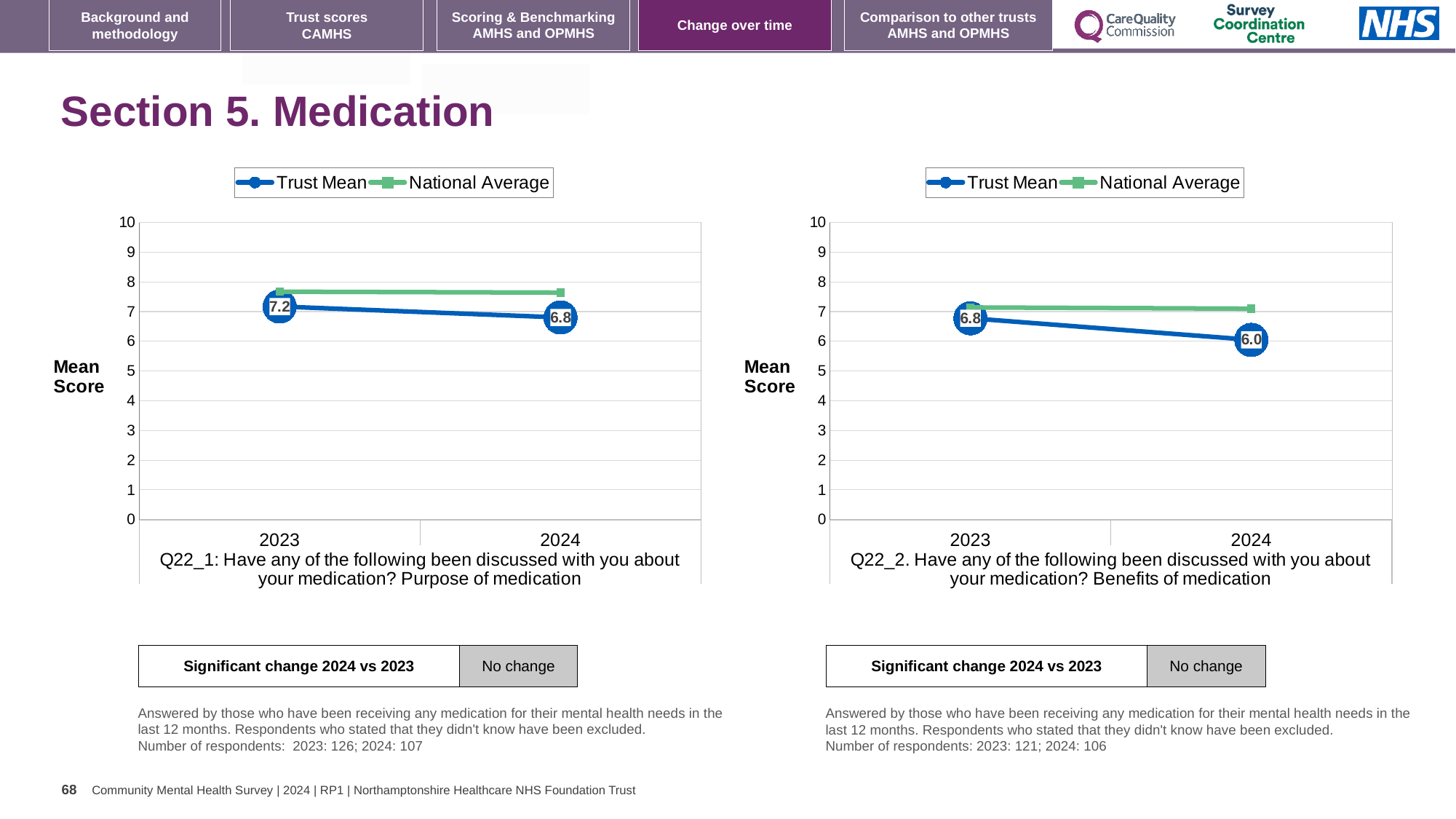
In the left chart (Q22_1: Purpose of medication), is the National Average for 2023 greater or less than 7? greater In the right chart (Q22_2: Benefits of medication), what is the Trust Mean score for 2024? 6.0 In the right chart (Q22_2: Benefits of medication), does the Trust Mean rise or fall from 2023 to 2024? fall In the right chart (Q22_2: Benefits of medication), what is the difference between the Trust Mean in 2023 and 2024? 0.8 How many series does the legend of the left chart list? 2 In the left chart (Q22_1: Purpose of medication), by how much did the Trust Mean change from 2023 to 2024? It fell by 0.4 In the left chart (Q22_1: Purpose of medication), what is the Trust Mean score for 2024? 6.8 How many years are plotted on the x axis of the right chart? 2 In the left chart (Q22_1: Purpose of medication), what is the Trust Mean score for 2023? 7.2 What kind of chart is the left chart (Q22_1: Purpose of medication)? line chart In the right chart (Q22_2: Benefits of medication), which is higher in 2024, the Trust Mean or the National Average? National Average In the right chart (Q22_2: Benefits of medication), what is the Trust Mean score for 2023? 6.8